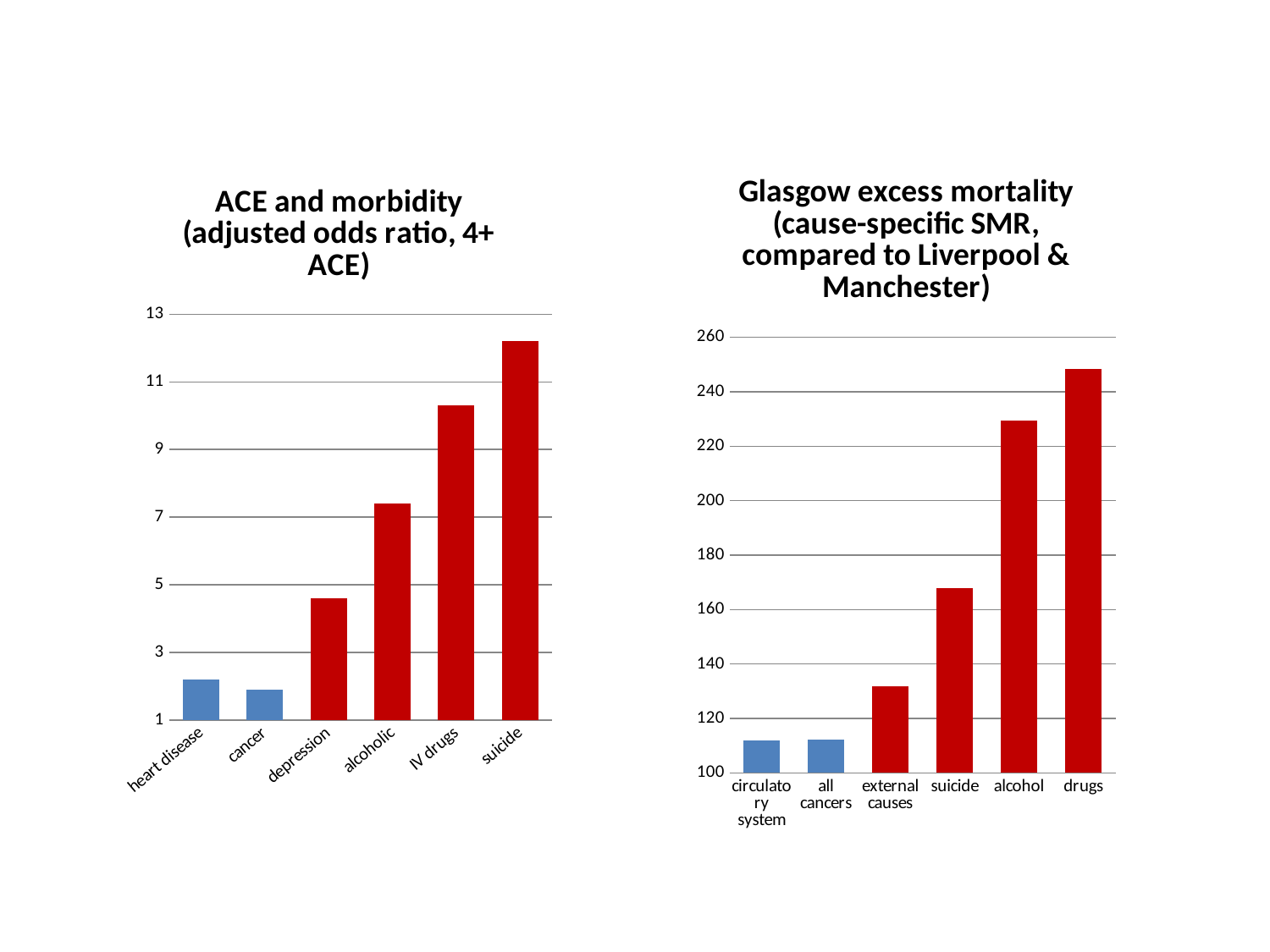
In the 'Glasgow excess mortality' chart, what colour are the bars for circulatory system and all cancers? blue In the 'ACE and morbidity' chart, is the value for depression greater or less than 5? less In the 'ACE and morbidity' chart, which is larger, the value for alcoholic or the value for depression? alcoholic In the 'ACE and morbidity' chart, which category has the highest value? suicide In the 'Glasgow excess mortality' chart, which is larger, the value for suicide or the value for external causes? suicide In the 'Glasgow excess mortality' chart, is the value for alcohol greater or less than 220? greater What kind of chart is the 'ACE and morbidity' chart? bar chart In the 'Glasgow excess mortality' chart, which category has the highest value? drugs In the 'ACE and morbidity' chart, is the value for IV drugs greater or less than 9? greater How many categories are shown in the 'ACE and morbidity' chart? 6 In the 'Glasgow excess mortality' chart, do the values generally rise or fall from left to right along the x axis? rise